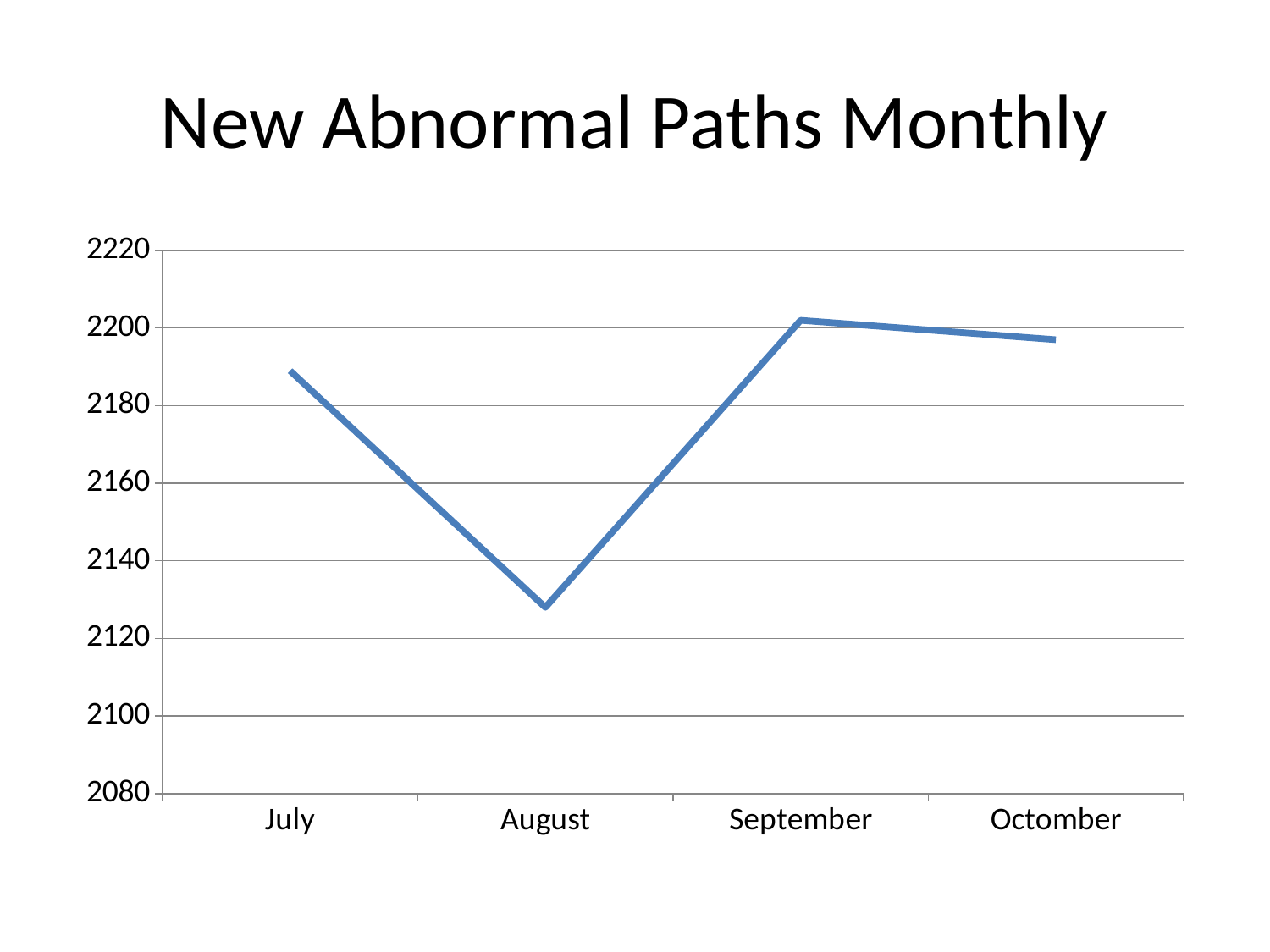
What kind of chart is shown on the slide? line chart Is the value for October greater or less than 2180? greater Is the value for August greater or less than 2140? less Which is larger, the value for July or the value for August? July Does the value rise or fall from July to August? fall Is the value for July greater or less than 2180? greater What is the title of the chart? New Abnormal Paths Monthly Does the value rise or fall from August to September? rise Which is larger, the value for September or the value for August? September How many months are plotted on the x axis? 4 Which month has the lowest value? August